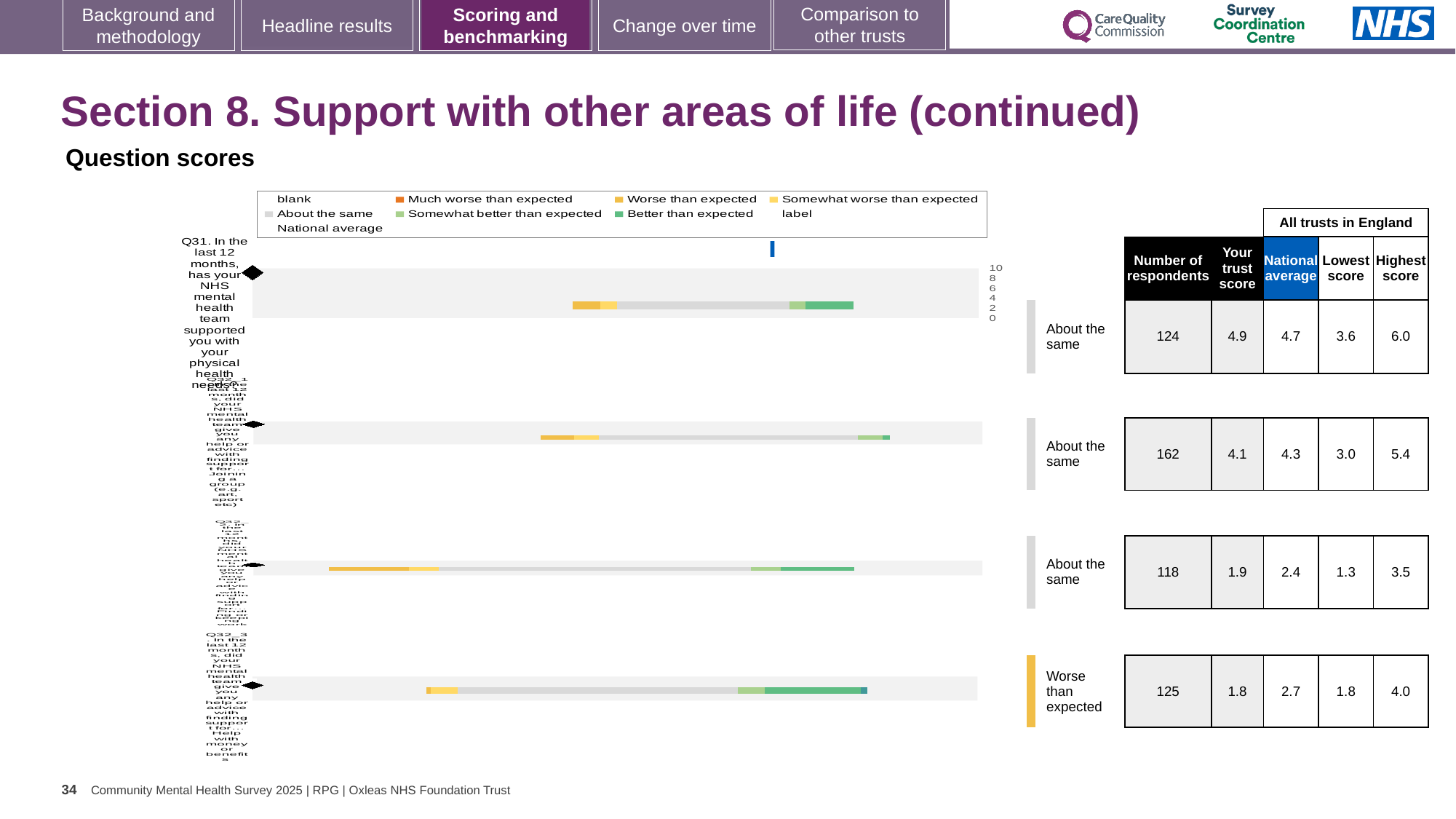
What is the highest value shown on the chart's score axis? 10 What is the lowest number of respondents among the four question rows? 118 How many entries does the chart legend list? 9 How many respondents answered Q31? 124 What colour does the legend use for 'Much worse than expected'? orange Which question row is rated 'Worse than expected'? Q32_3 (help with money or benefits) What kind of chart is shown under 'Question scores'? bar chart What is the trust score for Q31 (support with physical health needs)? 4.9 Which of the four question rows has the highest 'Your trust score'? Q31 For Q31, what is the difference between the highest score and the lowest score across all trusts in England? 2.4 How many question bars are plotted in the chart? 4 For Q31, which is larger: the trust score or the national average? trust score